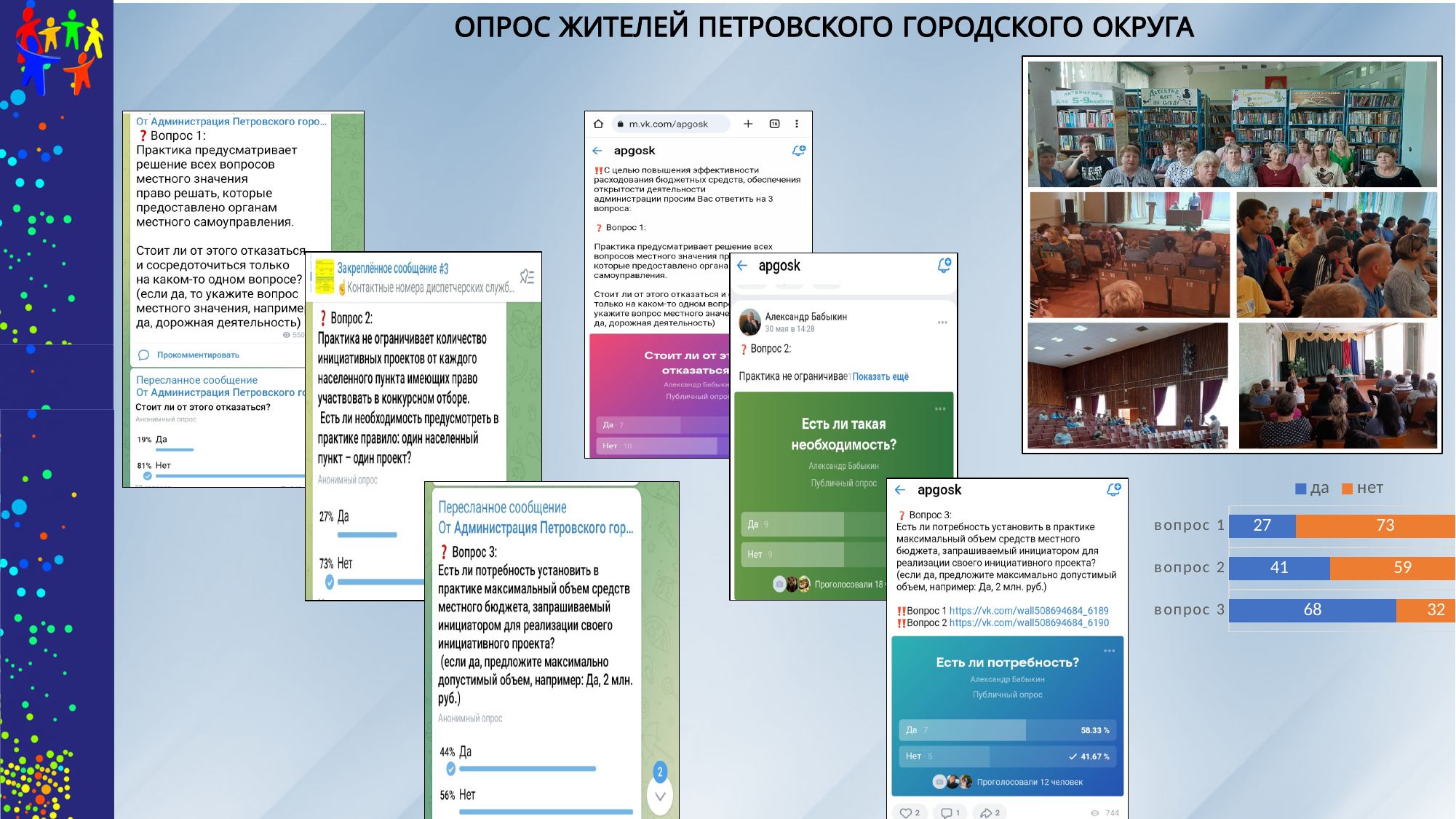
What type of chart is shown on the right side of the slide? bar chart How many series does the legend of the bar chart list? 2 In the bar chart, what is the value of "нет" for "вопрос 2"? 59 In the bar chart, which is larger for "вопрос 2": "да" or "нет"? нет In the bar chart, which question has the lowest "нет" value? вопрос 3 How many categories (questions) are shown in the bar chart? 3 In the bar chart, what is the value of "да" for "вопрос 1"? 27 In the bar chart, what is the value of "да" for "вопрос 3"? 68 In the bar chart, what is the difference between the "нет" and "да" values for "вопрос 1"? 46 In the bar chart, which question has the highest "да" value? вопрос 3 In the bar chart, what is the total of the stacked bar for "вопрос 3"? 100 In the bar chart, what is the value of "нет" for "вопрос 1"? 73